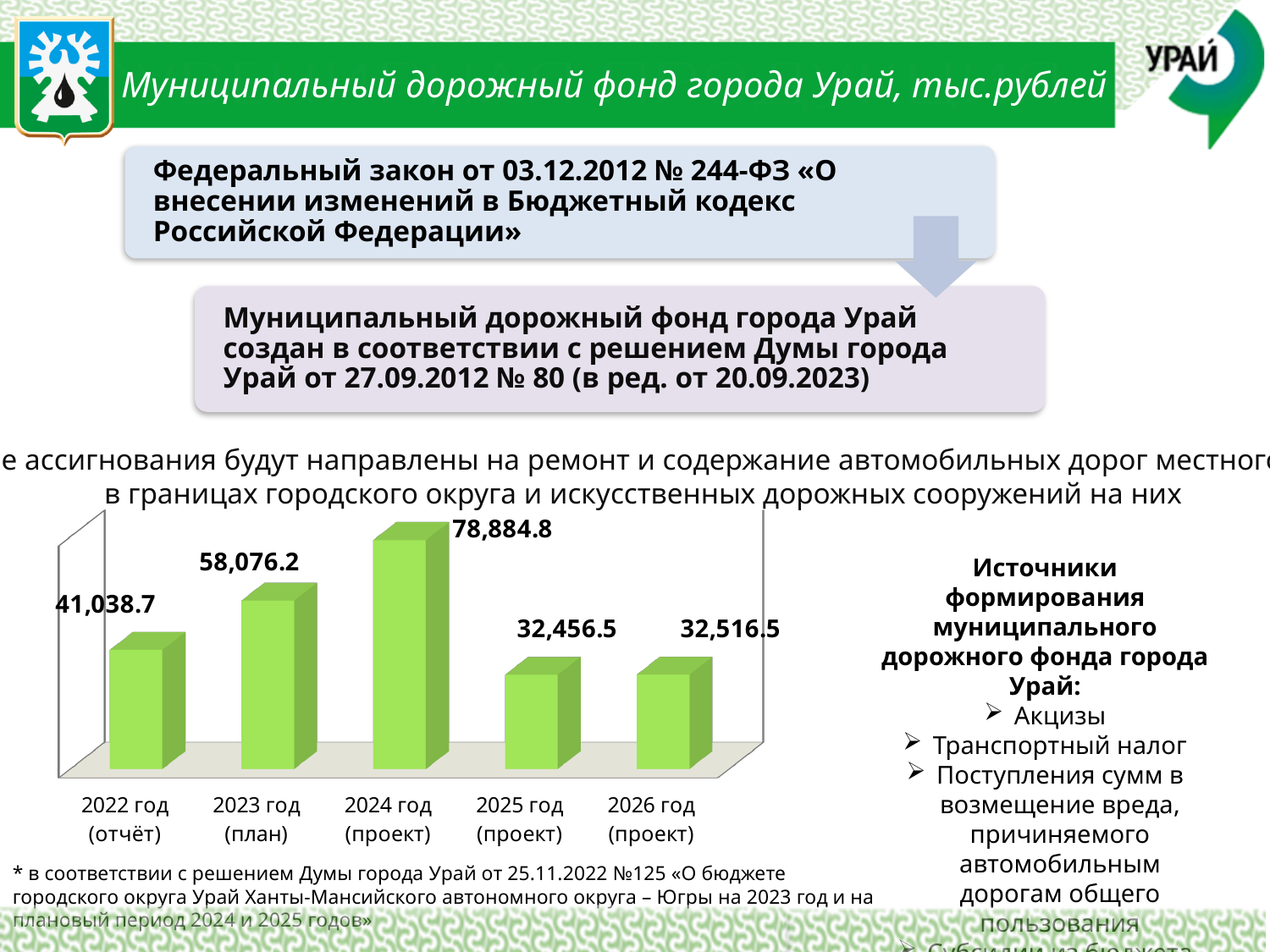
What is the difference between the values for 2023 год (план) and 2022 год (отчёт)? 17,037.5 What is the value for 2024 год (проект)? 78,884.8 What is the value for 2023 год (план)? 58,076.2 How many years are shown on the chart? 5 Do the values rise or fall from 2022 год (отчёт) to 2024 год (проект)? rise What kind of chart is shown on the slide? bar chart What is the difference between the values for 2024 год (проект) and 2023 год (план)? 20,808.6 Which is larger, the value for 2022 год (отчёт) or 2025 год (проект)? 2022 год (отчёт) What is the value for 2025 год (проект)? 32,456.5 Which year has the highest value? 2024 год (проект) What is the value for 2022 год (отчёт)? 41,038.7 What is the value for 2026 год (проект)? 32,516.5